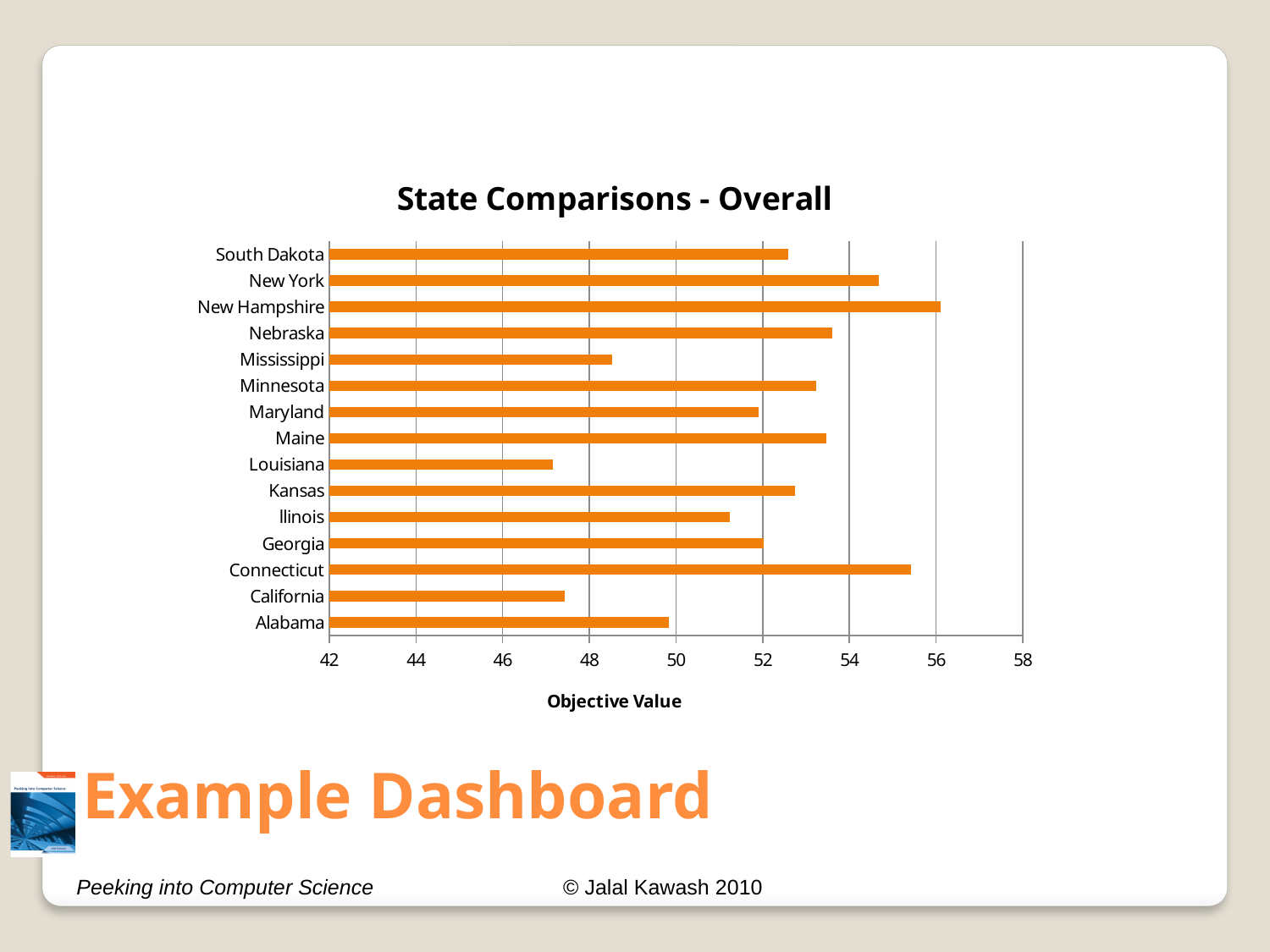
Is the value for New York greater or less than 54? greater What is the label on the horizontal axis of the chart? Objective Value Is the value for Nebraska greater or less than 52? greater Which state has the highest objective value? New Hampshire What is the title of the chart? State Comparisons - Overall What kind of chart is shown on the slide? Bar chart Which has a higher objective value, New York or Nebraska? New York Is the value for Louisiana greater or less than 48? less How many states are shown in the chart? 15 Which has a higher objective value, Connecticut or South Dakota? Connecticut Which has a lower objective value, Mississippi or Alabama? Mississippi